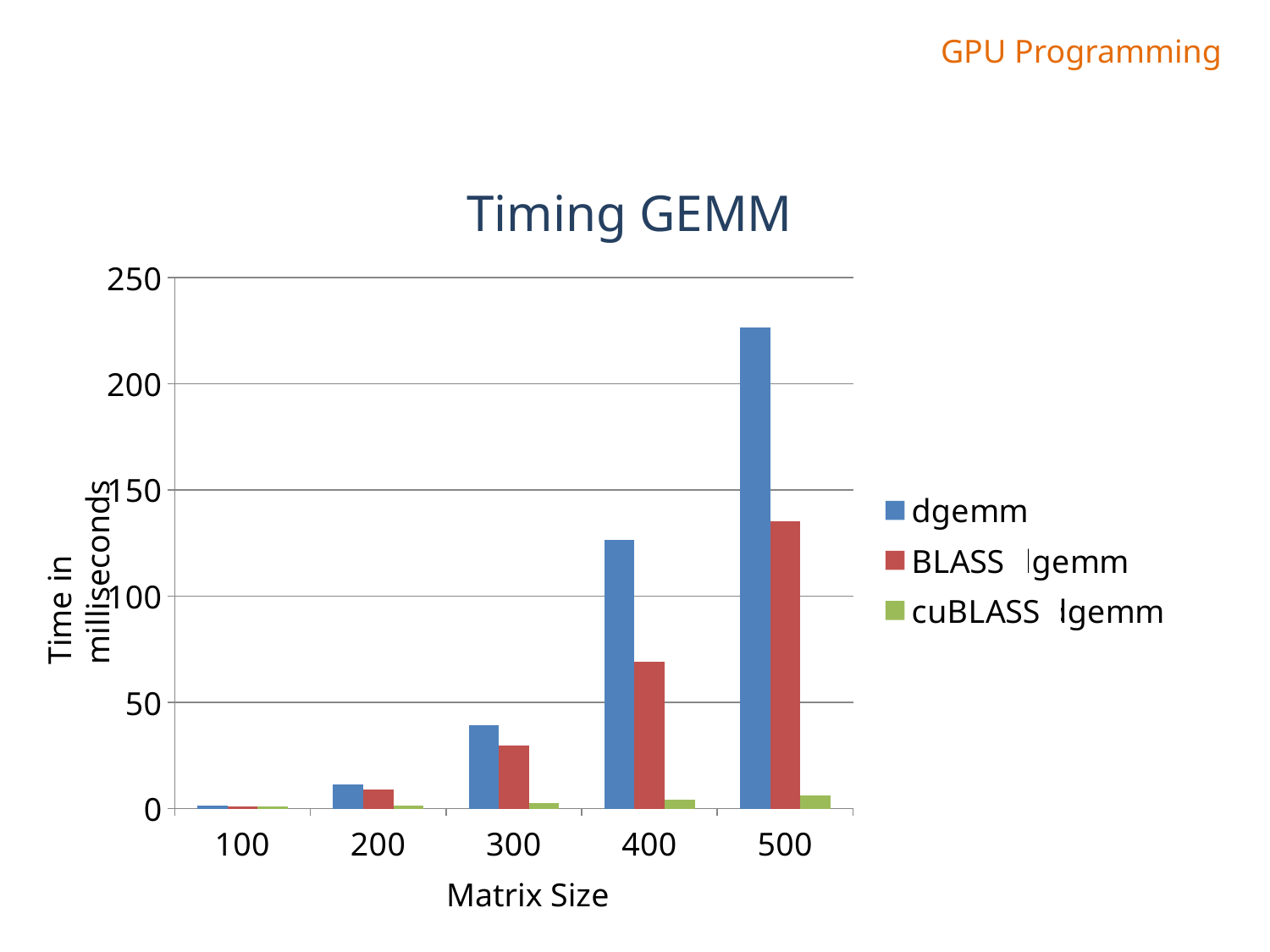
For which matrix size is the dgemm time lowest? 100 Is the dgemm value for matrix size 300 greater or less than 50? less How many matrix sizes are shown on the x axis? 5 What is the title of the chart? Timing GEMM How many series does the legend list? 3 Is the dgemm value for matrix size 500 greater or less than 200? greater What kind of chart is shown on the slide? bar chart Do the dgemm times rise or fall as the matrix size increases along the x axis? rise What is the label of the x axis? Matrix Size For which matrix size is the dgemm time highest? 500 Is the value of the red series for matrix size 400 greater or less than 50? greater At matrix size 400, which is larger: the dgemm (blue) bar or the red bar? dgemm (blue)